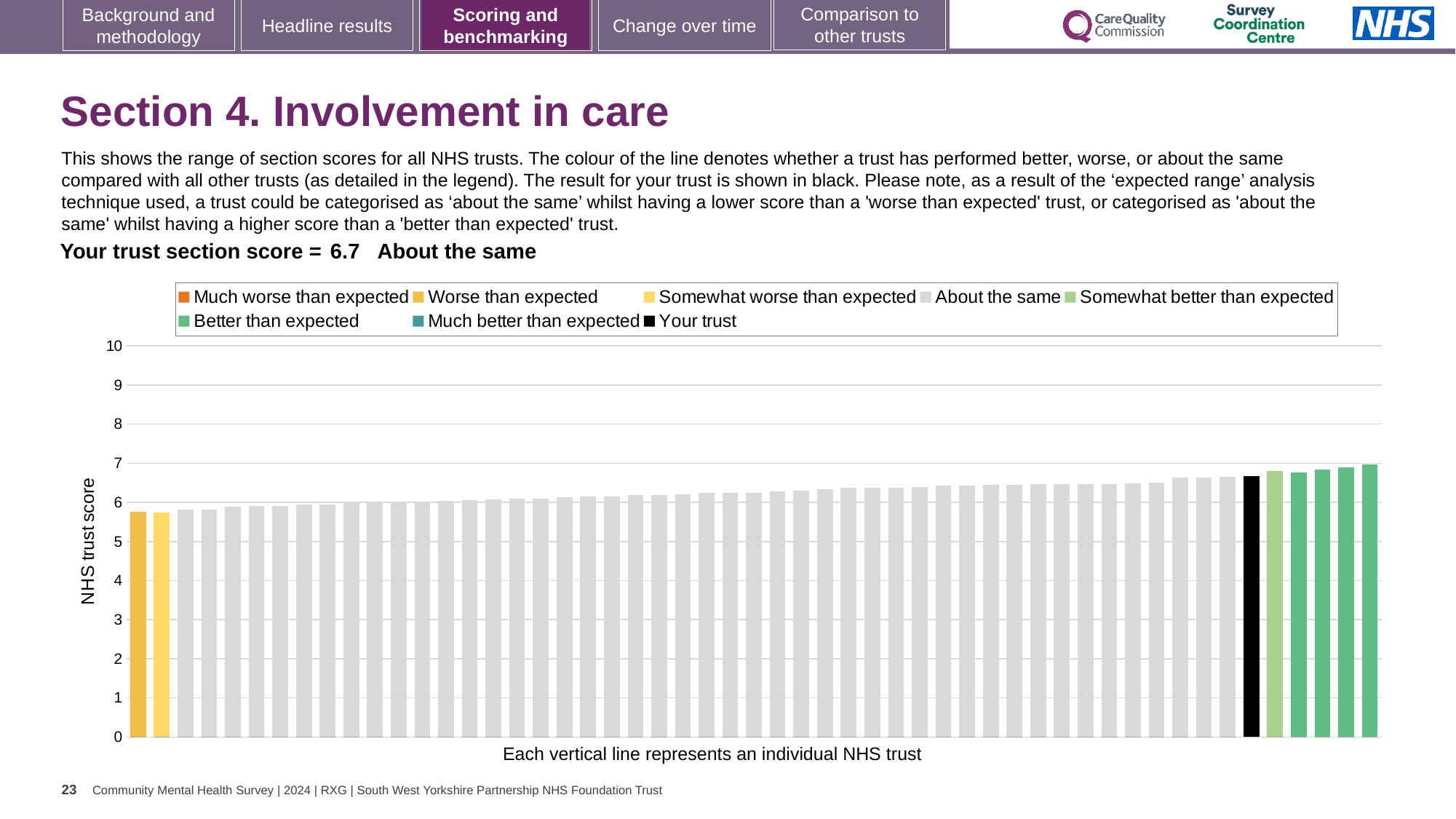
Is the value for the leftmost bar greater or less than 5? greater Which performance category is your trust placed in for this section? About the same How many entries does the chart legend list? 8 Do the bar values rise or fall from left to right along the x axis? rise What is the label on the vertical axis of the chart? NHS trust score What is the section score for your trust shown on the slide? 6.7 How many bars are coloured yellow (worse or somewhat worse than expected) on the chart? 2 Is the value for the leftmost bar greater or less than 6? less Is the value for the rightmost bar greater or less than 6? greater What kind of chart is shown on the slide? bar chart How many green bars (somewhat better or better than expected) appear to the right of the black 'Your trust' bar? 5